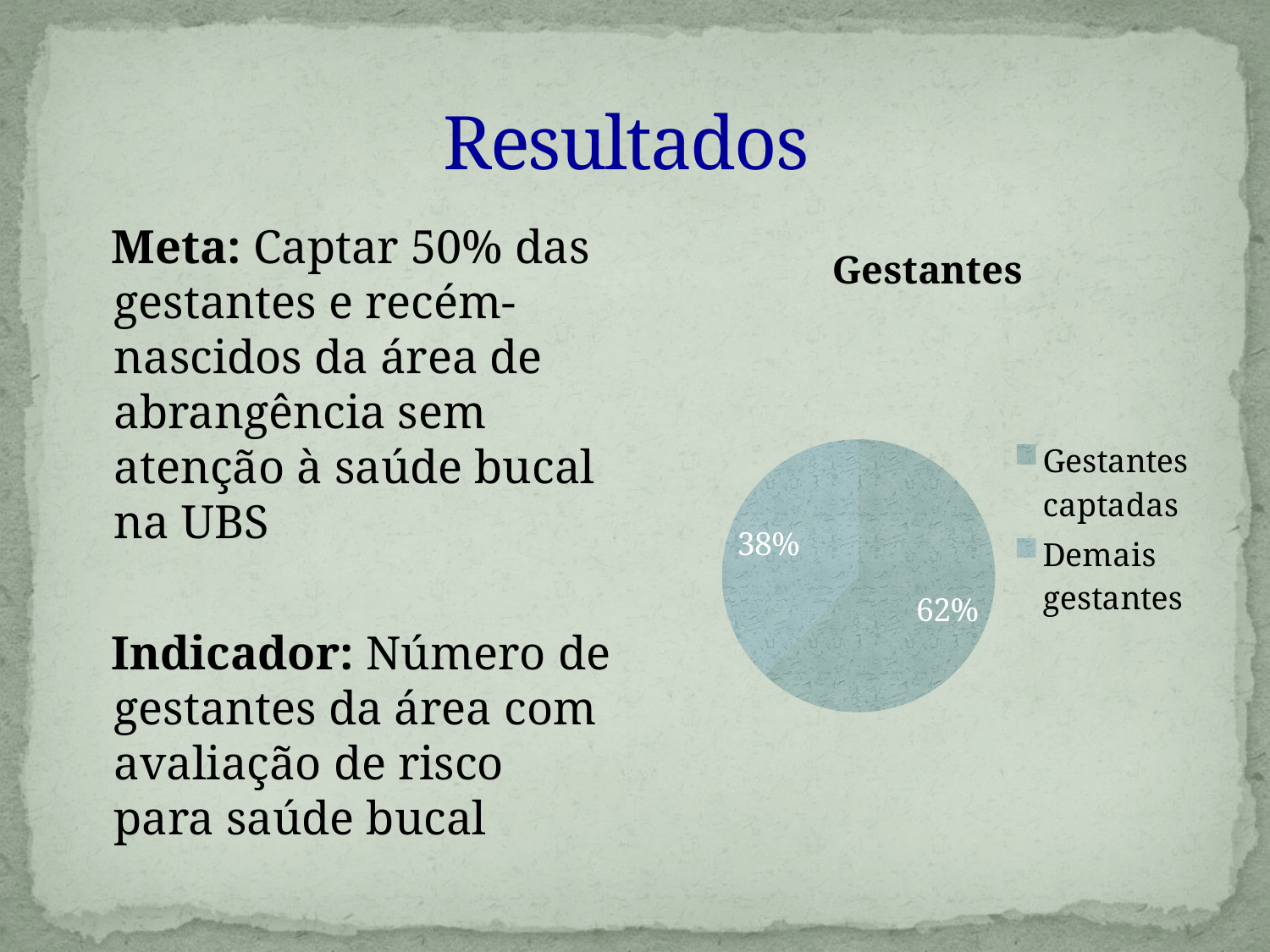
What share of the pie is labelled for Gestantes captadas? 62% Which slice of the pie is the largest? Gestantes captadas Which is larger, the slice for Gestantes captadas or the slice for Demais gestantes? Gestantes captadas What share of the pie is labelled for Demais gestantes? 38% How many slices does the pie chart have? 2 What are the two legend entries of the chart? Gestantes captadas; Demais gestantes What kind of chart is shown on the slide? pie chart How many entries does the chart legend list? 2 What is the title of the chart? Gestantes Which slice of the pie is the smallest? Demais gestantes What is the total of the two percentages shown on the pie chart? 100% What is the difference in percentage points between the two slices of the pie? 24